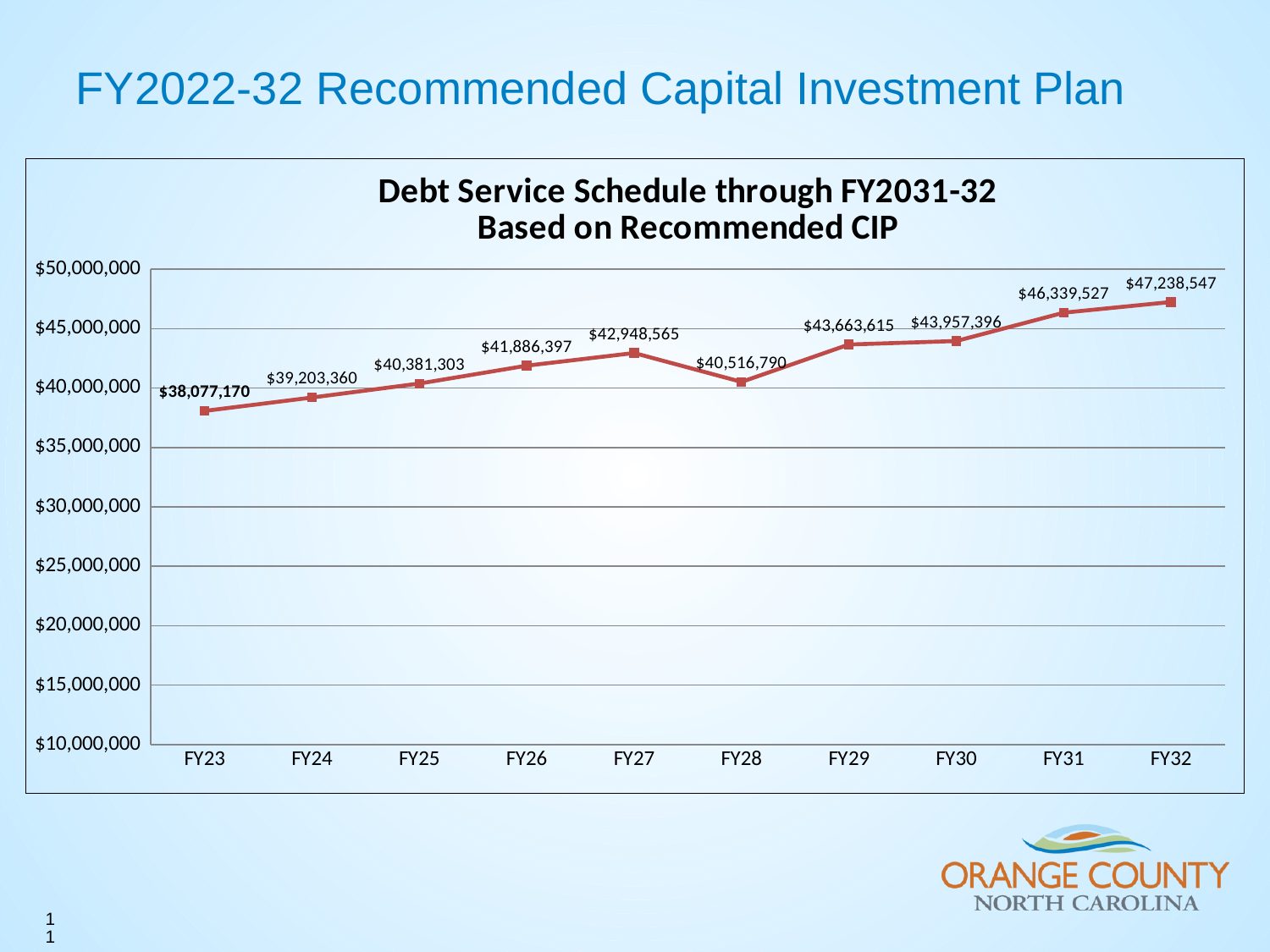
What is the debt service value for FY28? $40,516,790 What is the debt service value for FY32? $47,238,547 Which is larger, the value for FY27 or the value for FY28? FY27 What type of chart is shown on the slide? Line chart Is the value for FY31 greater or less than $45,000,000? greater What is the difference between the FY32 value and the FY23 value? $9,161,377 What is the title of the chart? Debt Service Schedule through FY2031-32 Based on Recommended CIP Which fiscal year has the highest debt service value? FY32 How many fiscal years are plotted on the chart? 10 Which fiscal year has the lowest debt service value? FY23 By how much does the value drop from FY27 to FY28? $2,431,775 What is the debt service value for FY23? $38,077,170